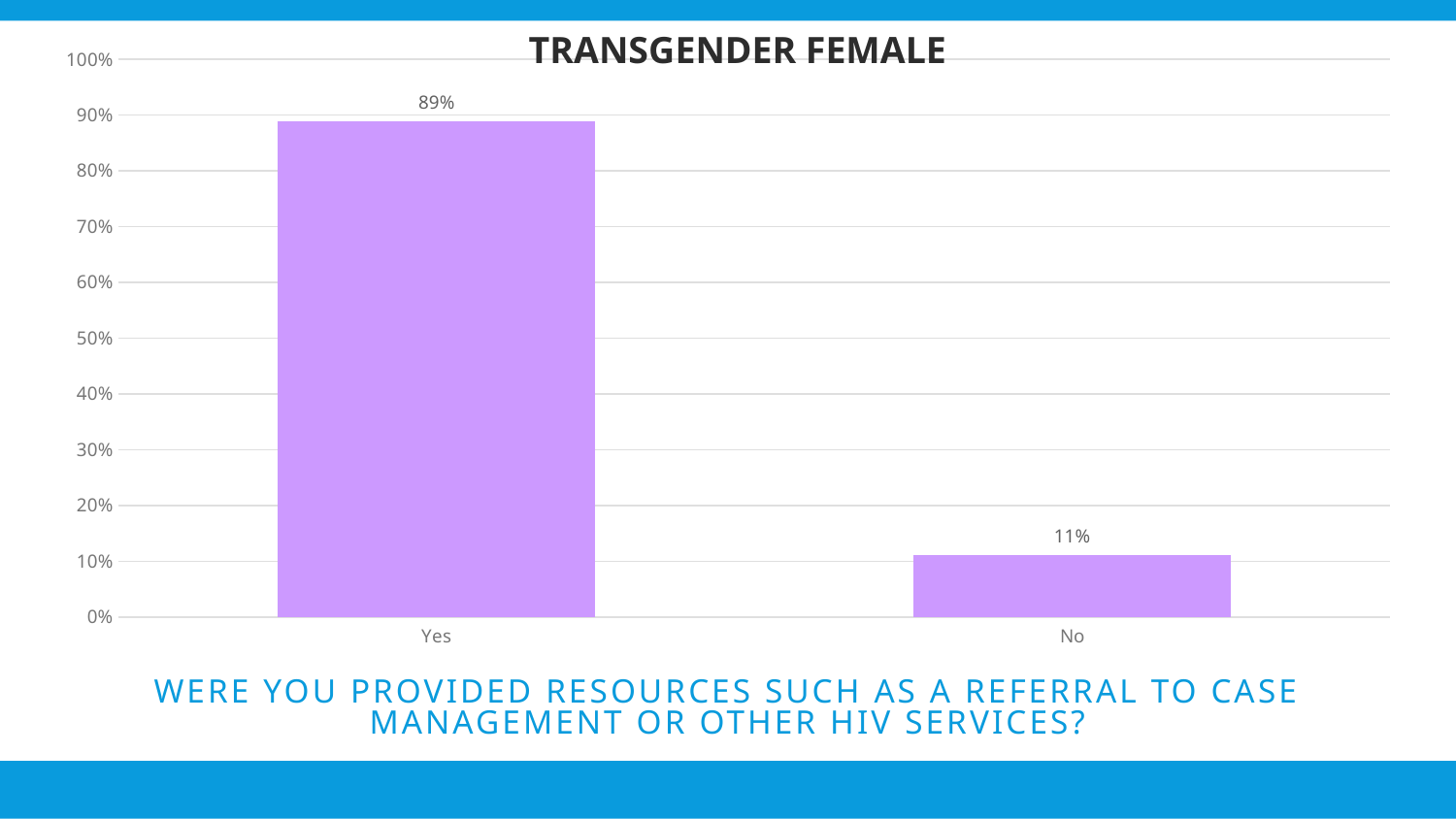
What is the title of the chart? TRANSGENDER FEMALE Which category has the highest value? Yes What is the difference between the "Yes" and "No" percentages? 78% How many categories are shown on the x axis? 2 Which is larger, the value for "Yes" or the value for "No"? Yes What percentage of respondents answered "No"? 11% What percentage of respondents answered "Yes"? 89% What is the highest value shown on the y axis? 100% Is the value for "No" greater or less than 20%? less Is the value for "Yes" greater or less than 80%? greater Which category has the lowest value? No What kind of chart is shown on the slide? Bar chart